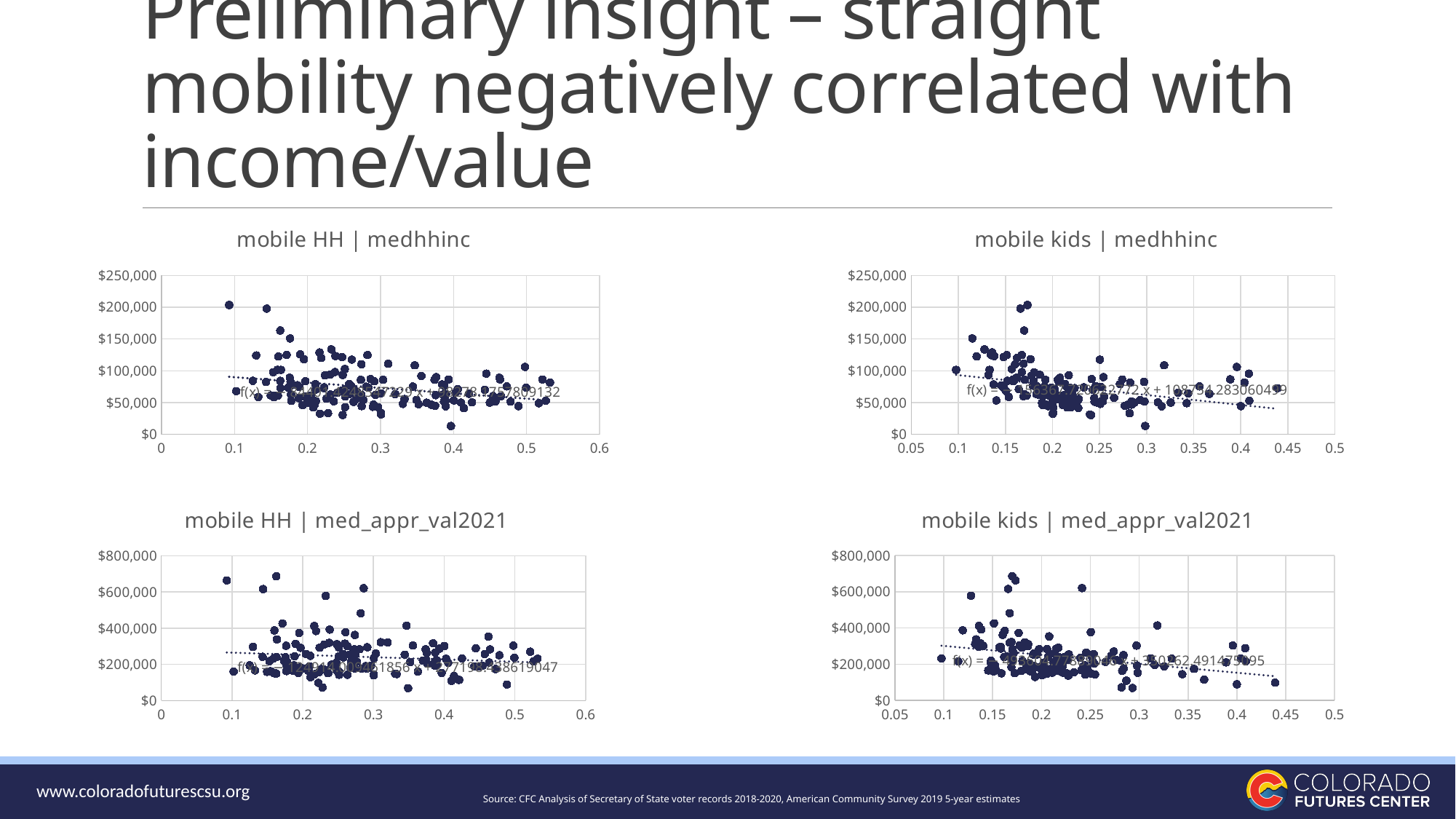
What kind of chart is "mobile HH | medhhinc"? scatter chart In the "mobile HH | medhhinc" chart, does the dotted trendline rise or fall as the x value increases? fall In the "mobile kids | med_appr_val2021" chart, is the highest plotted point greater or less than $800,000? less In the "mobile HH | medhhinc" chart, is the lowest plotted point greater or less than $50,000? less In the "mobile HH | med_appr_val2021" chart, is the highest plotted point greater or less than $600,000? greater In the "mobile HH | med_appr_val2021" chart, does the dotted trendline rise or fall along the x axis? fall How many charts are shown on the slide? 4 What is the highest y-axis tick shown on the "mobile kids | medhhinc" chart? $250,000 In the "mobile kids | med_appr_val2021" chart, does the dotted trendline rise or fall along the x axis? fall What is the title of the chart in the top-right position of the slide? mobile kids | medhhinc What is the highest y-axis tick shown on the "mobile HH | med_appr_val2021" chart? $800,000